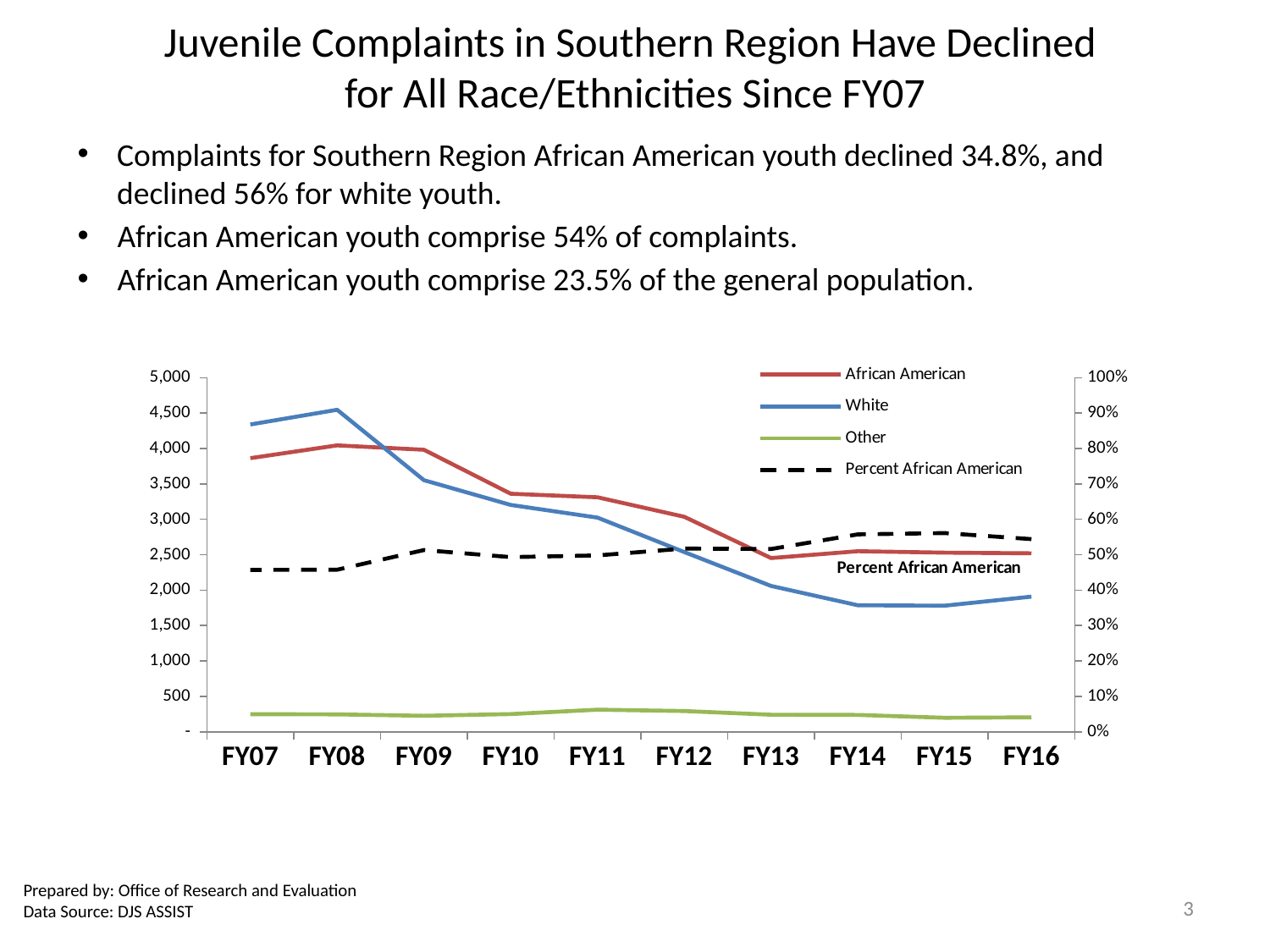
In which fiscal year does the White series reach its highest value? FY08 What kind of chart is shown on the slide? line chart How many series does the chart legend list? 4 Does the White series rise or fall from FY07 to FY16? fall How many fiscal years are plotted along the x axis? 10 Is the Percent African American value in FY07 greater or less than 50%? less Which of the three count series (African American, White, Other) has the lowest values across all years? Other Is the value for White in FY08 greater or less than 4,000? greater In FY07, which series has the larger value, White or African American? White Is the value for African American in FY13 greater or less than 3,000? less In FY16, which series has the larger value, African American or White? African American